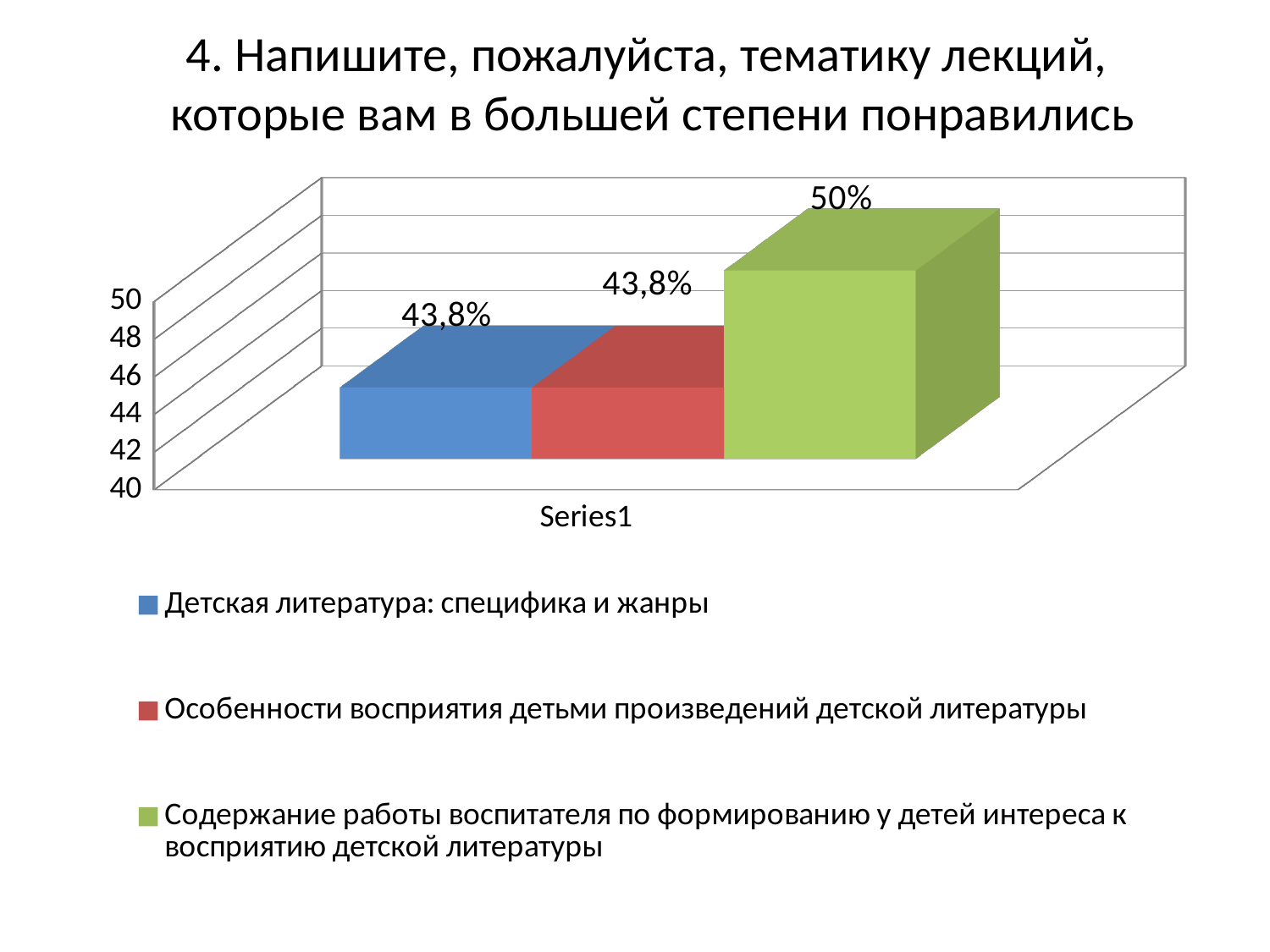
Is the value for "Детская литература: специфика и жанры" greater or less than 46? less What value is shown for "Детская литература: специфика и жанры"? 43,8% What value is shown for "Особенности восприятия детьми произведений детской литературы"? 43,8% What colour is the bar for "Содержание работы воспитателя по формированию у детей интереса к восприятию детской литературы"? green What value is shown for "Содержание работы воспитателя по формированию у детей интереса к восприятию детской литературы"? 50% How many series does the legend list? 3 What is the difference between the value for "Содержание работы воспитателя..." and the value for "Детская литература: специфика и жанры"? 6,2% What is the category label shown on the x axis? Series1 What kind of chart is shown on the slide? bar chart Is the value for "Содержание работы воспитателя..." greater or less than 48? greater Which is larger: the value for "Содержание работы воспитателя..." or the value for "Особенности восприятия детьми произведений детской литературы"? Содержание работы воспитателя по формированию у детей интереса к восприятию детской литературы Which legend entry has the highest value? Содержание работы воспитателя по формированию у детей интереса к восприятию детской литературы